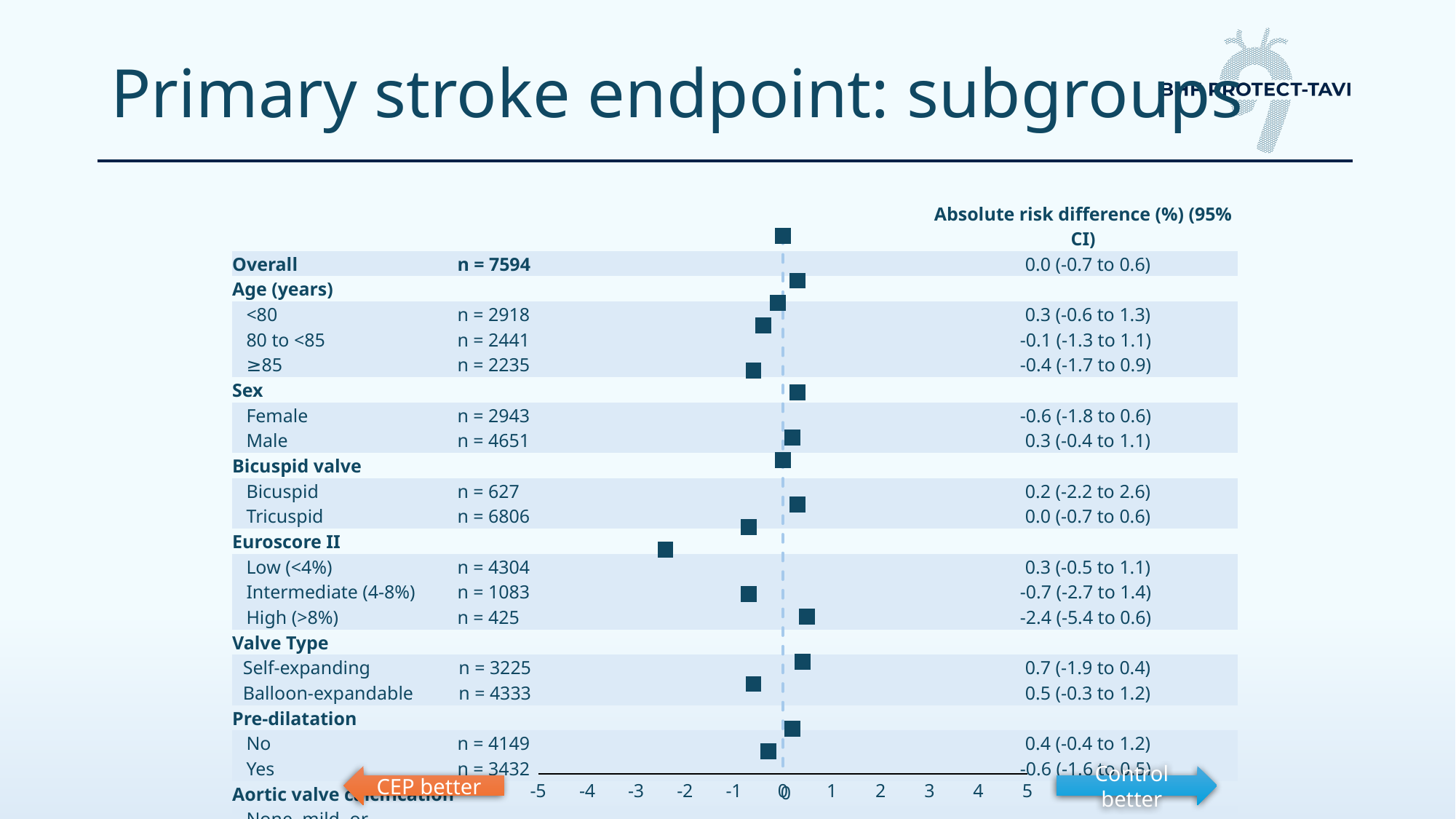
Which subgroup has the lowest point estimate for absolute risk difference? High (>8%) Euroscore II What is the absolute risk difference (%) for the Overall group? 0.0 (-0.7 to 0.6) What is the difference between the point estimates for Male (0.3) and Female (-0.6)? 0.9 What is the absolute risk difference (%) for the Balloon-expandable valve type subgroup? 0.5 (-0.3 to 1.2) What does the orange arrow at the left end of the x axis say? CEP better What is the number of patients (n) in the Female subgroup? n = 2943 What is the absolute risk difference (%) for the High (>8%) Euroscore II subgroup? -2.4 (-5.4 to 0.6) What kind of chart is shown on the slide? Forest plot What is the range of the x axis shown on the chart? -5 to 5 Which has the larger number of patients: the Bicuspid or the Tricuspid subgroup? Tricuspid Which has the larger point estimate for absolute risk difference: the <80 age subgroup or the ≥85 age subgroup? <80